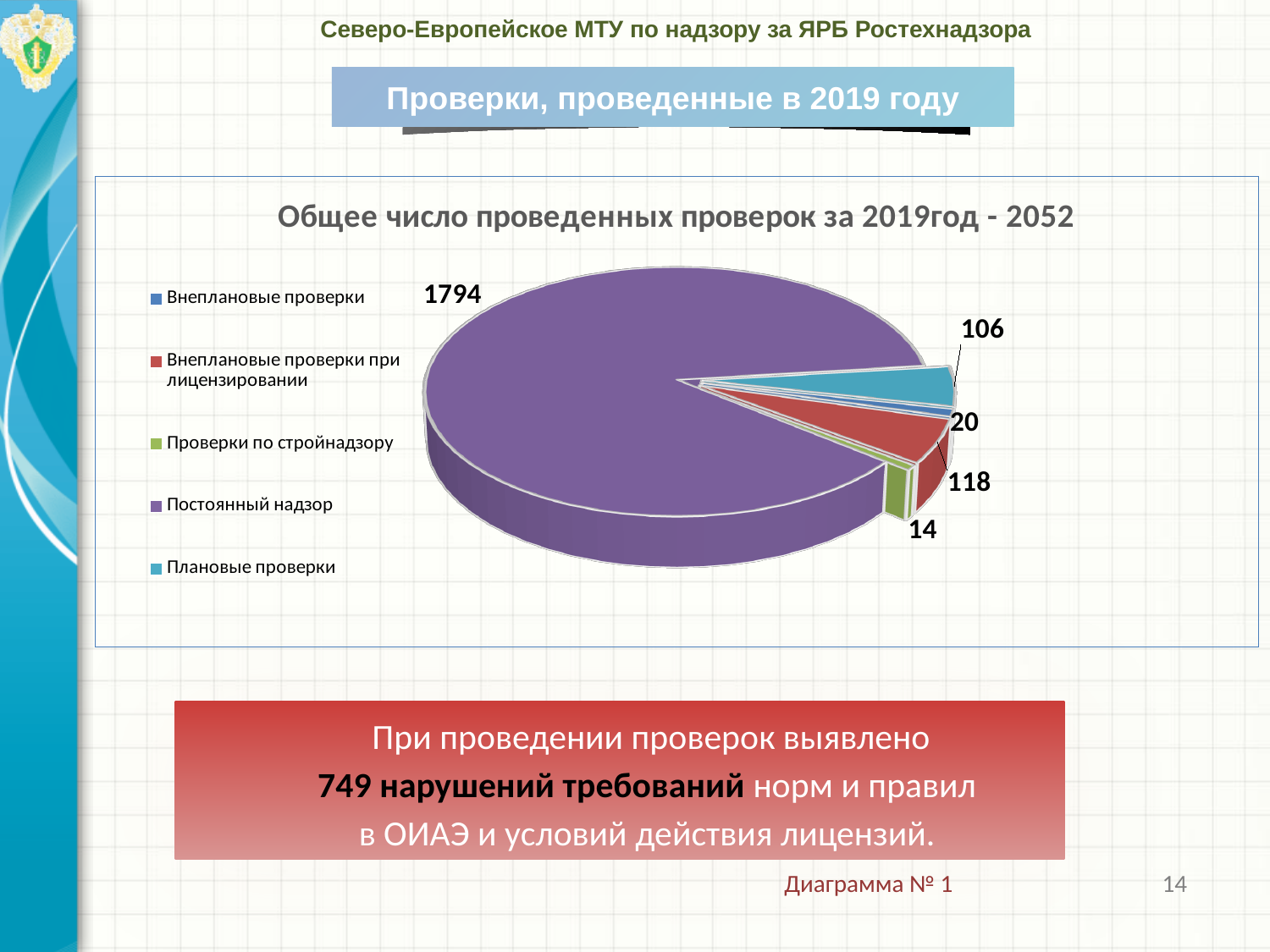
What is the value for Плановые проверки? 106 What is the value for Проверки по стройнадзору? 14 What is the value for Постоянный надзор? 1794 Which category has the largest slice of the pie? Постоянный надзор What is the title of the chart? Общее число проведенных проверок за 2019год - 2052 What kind of chart is shown on the slide? Pie chart What is the difference between the values for Внеплановые проверки при лицензировании and Плановые проверки? 12 What is the value for Внеплановые проверки? 20 What is the value for Внеплановые проверки при лицензировании? 118 How many categories does the legend list? 5 Which category has the smallest slice of the pie? Проверки по стройнадзору Which is larger: Плановые проверки or Внеплановые проверки? Плановые проверки